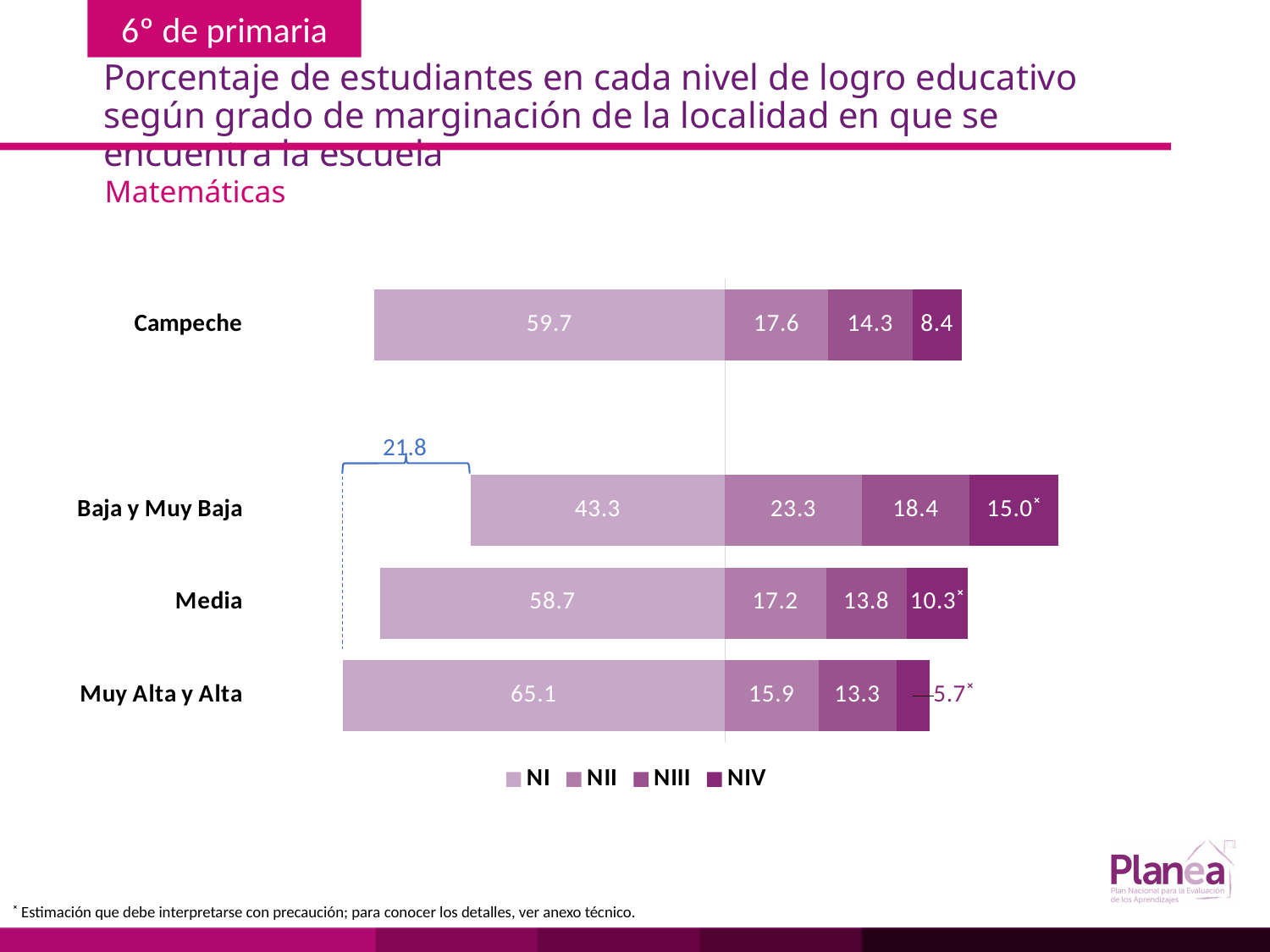
Which is larger, the NII value for Baja y Muy Baja or the NII value for Campeche? Baja y Muy Baja Which category has the highest NI value? Muy Alta y Alta What is the difference between the NI values for Muy Alta y Alta and Baja y Muy Baja? 21.8 What is the NII value for Media? 17.2 What type of chart is shown on the slide? Stacked bar chart What is the NI value for Campeche? 59.7 How many categories are plotted on the chart? 4 What is the total of the stacked bar for Media? 100.0 What is the NIII value for Muy Alta y Alta? 13.3 What is the NIV value for Baja y Muy Baja? 15.0 How many series does the legend list? 4 Which category has the lowest NIV value? Muy Alta y Alta